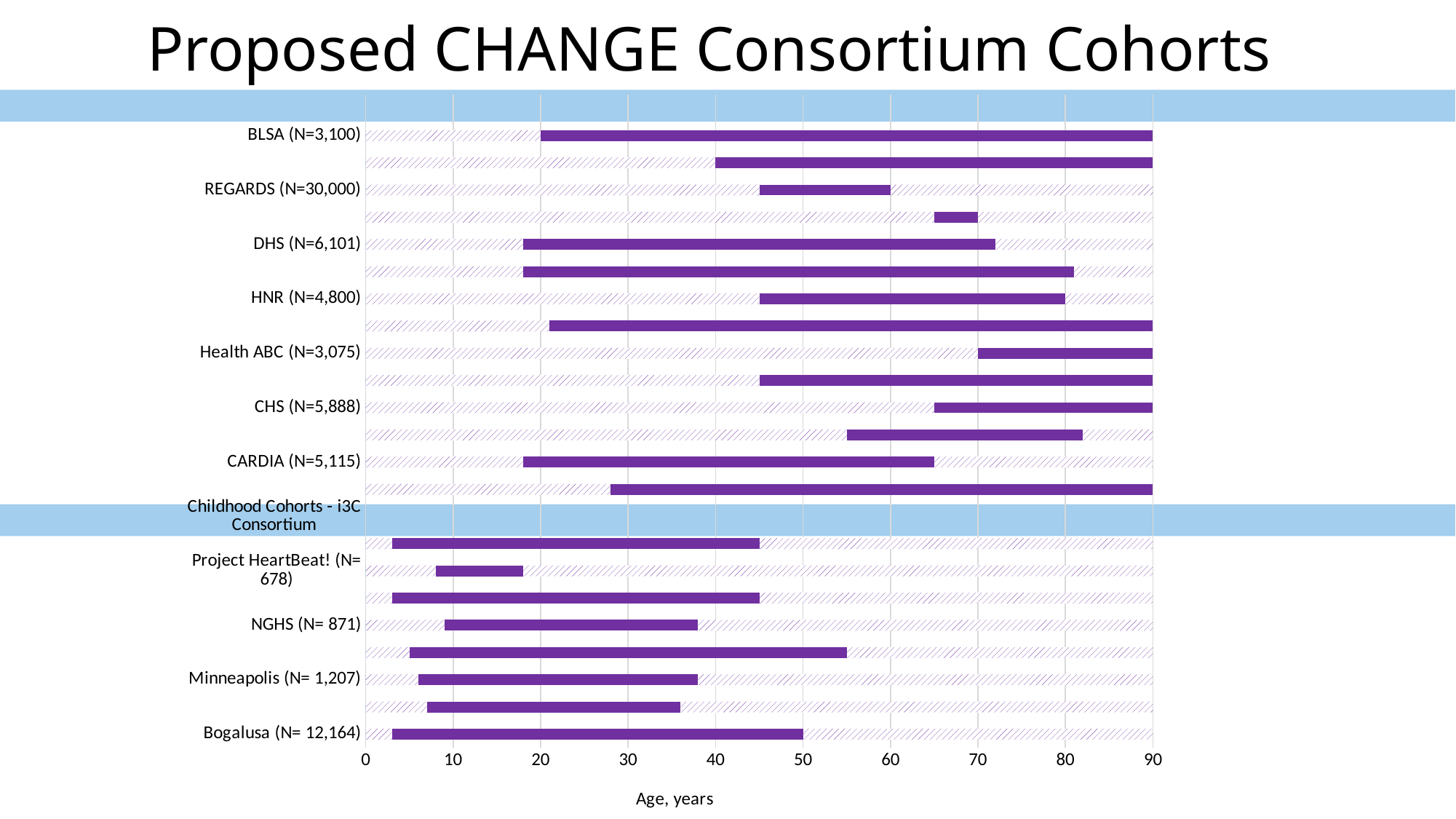
What kind of chart is shown on the slide? bar chart At what age does the HNR (N=4,800) bar end? 80 Which bar extends to a higher age, CARDIA (N=5,115) or Bogalusa (N= 12,164)? CARDIA (N=5,115) Is the upper end of the DHS (N=6,101) bar greater or less than 70? greater Is the upper end of the NGHS (N= 871) bar greater or less than 30? greater At what age does the BLSA (N=3,100) bar begin? 20 What is the highest age value shown on the x axis? 90 Is the lower end of the Minneapolis (N= 1,207) bar greater or less than 10? less What is the title of the x axis? Age, years At what age does the Bogalusa (N= 12,164) bar end? 50 At what age does the REGARDS (N=30,000) bar end? 60 At what age does the Health ABC (N=3,075) bar begin? 70